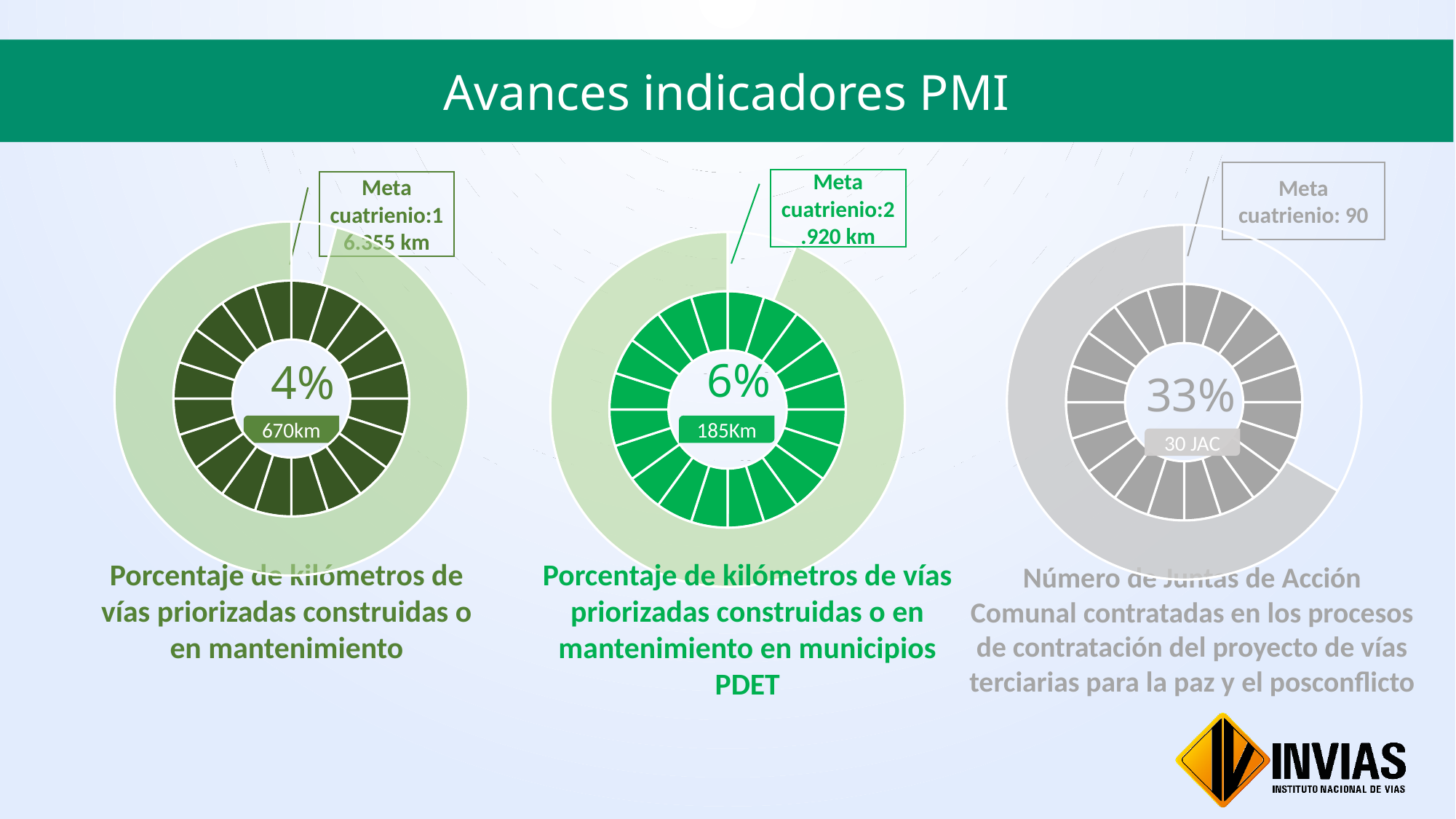
What percentage is shown in the centre of the right chart, 'Número de Juntas de Acción Comunal contratadas'? 33% Which of the three charts shows the highest percentage? Número de Juntas de Acción Comunal contratadas (33%) What kind of chart is used for each indicator on the slide? Donut (pie) chart Which of the three charts shows the lowest percentage? Porcentaje de kilómetros de vías priorizadas construidas o en mantenimiento (4%) In the left chart, how many kilometres are shown below the percentage? 670km In the right chart, what value is shown below the 33%? 30 JAC In the middle chart, how many kilometres are shown below the percentage? 185Km What is the 'Meta cuatrienio' shown for the right chart? 90 What percentage is shown in the centre of the middle chart, 'Porcentaje de kilómetros de vías priorizadas construidas o en mantenimiento en municipios PDET'? 6% How many charts are shown on the slide? 3 What percentage is shown in the centre of the left chart, 'Porcentaje de kilómetros de vías priorizadas construidas o en mantenimiento'? 4% What is the difference in percentage points between the right chart (33%) and the left chart (4%)? 29 percentage points